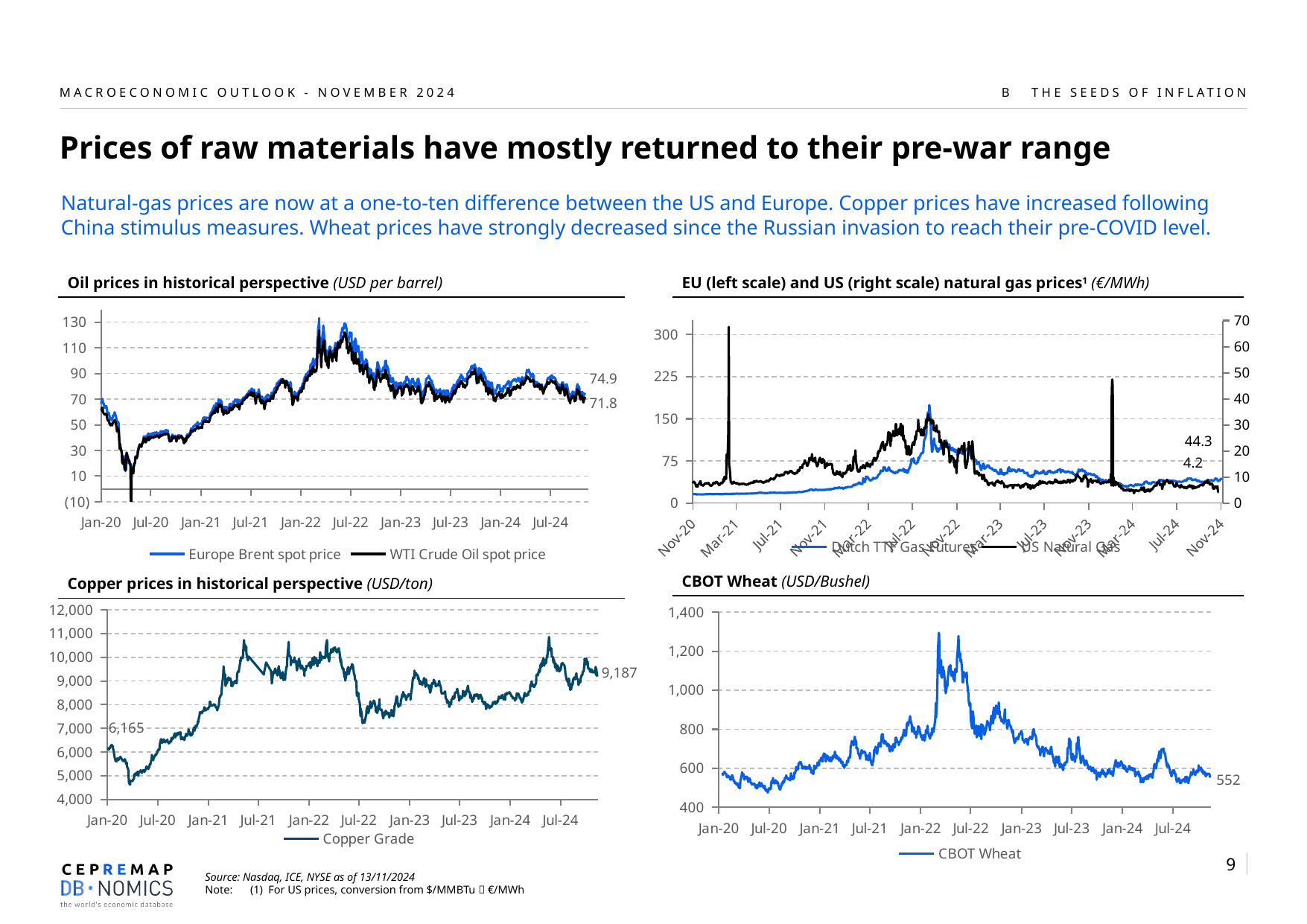
On the oil prices chart, what is the latest value shown for the WTI Crude Oil spot price? 71.8 On the copper prices chart, what is the value labelled at the start of the series in Jan-20? 6,165 On the oil prices chart, what is the latest value shown for the Europe Brent spot price? 74.9 On the oil prices chart, which series has the higher latest value, Europe Brent or WTI Crude Oil? Europe Brent spot price On the natural gas prices chart, what is the latest value shown for Dutch TTF Gas Futures? 44.3 How many series does the legend of the oil prices chart list? 2 On the copper prices chart, what is the latest value shown for Copper Grade? 9,187 On the CBOT Wheat chart, is the peak value in 2022 greater or less than 1,200? greater On the oil prices chart, what is the difference between the latest Brent value and the latest WTI value? 3.1 On the CBOT Wheat chart, what is the latest value shown? 552 On the copper prices chart, what is the difference between the latest value (9,187) and the starting value (6,165)? 3,022 On the natural gas prices chart, what is the latest value shown for US Natural Gas? 4.2